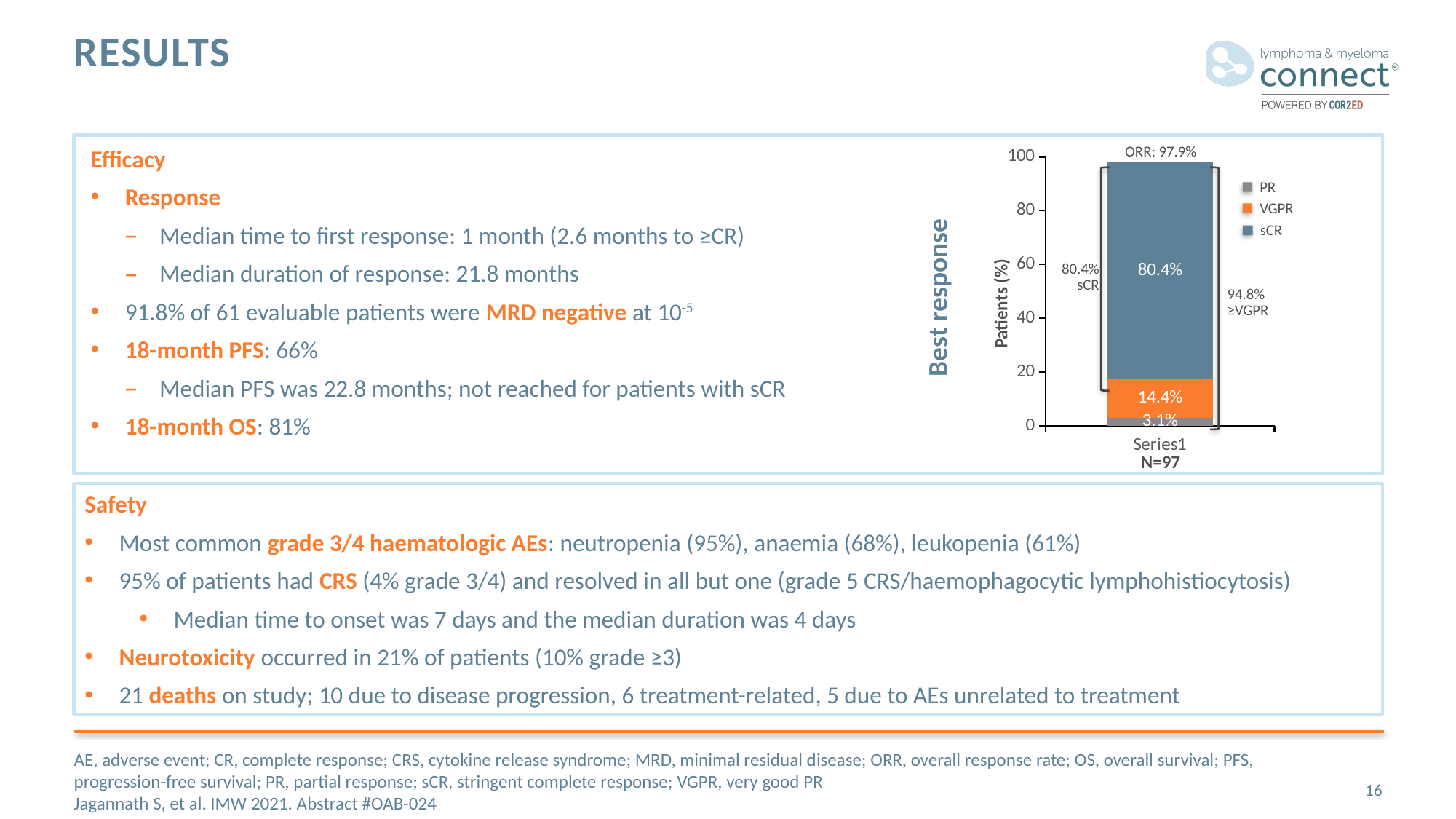
What percentage of patients achieved VGPR as best response? 14.4% Which best response category has the largest share of patients? sCR What is the difference between the sCR and VGPR percentages? 66.0% What percentage of patients achieved PR as best response? 3.1% What kind of chart is shown on the slide? stacked bar chart What percentage of patients achieved sCR as best response? 80.4% What is the ORR value annotated above the bar? 97.9% Which best response category has the smallest share of patients? PR What is the total of the stacked bar (PR + VGPR + sCR)? 97.9% What is the label of the y axis? Patients (%) Which is larger, the VGPR percentage or the PR percentage? VGPR How many series does the legend list? 3